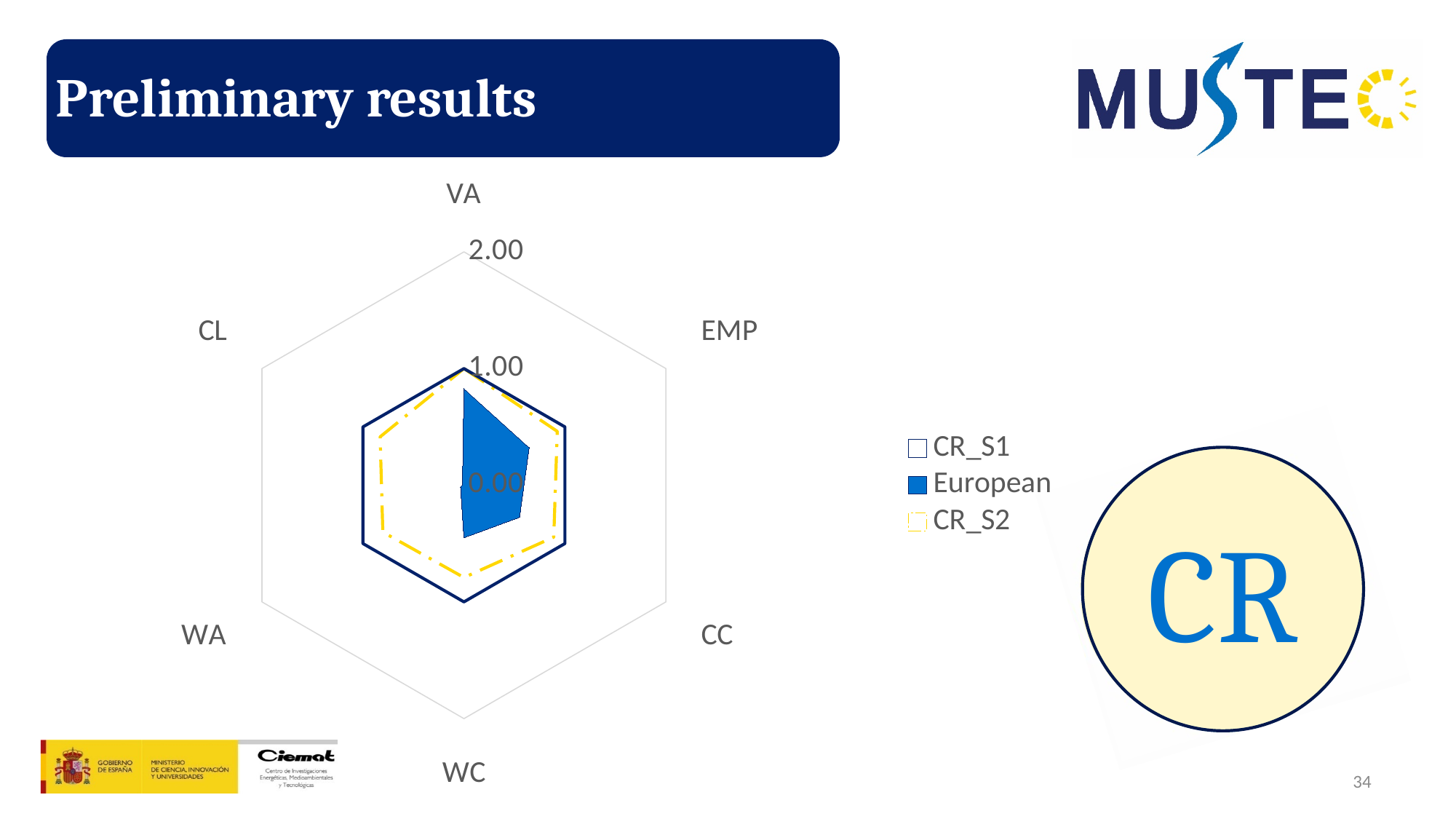
For the European series, which is larger: the value for EMP or the value for CC? EMP On the WC axis, which series has the larger value: CR_S1 or CR_S2? CR_S1 How many series does the legend list? 3 Is the European value for EMP greater or less than 1.00? less On which axis does the European series reach its highest value? VA How many axes (categories) does the radar chart have? 6 What kind of chart is shown on the slide? Radar chart Is the European value for CC greater or less than 1.00? less What is the highest value shown on the radar chart's axis scale? 2.00 Is the CR_S1 value for WC greater or less than 2.00? less Which series are listed in the legend? CR_S1, European, CR_S2 For the European series, which is larger: the value for VA or the value for WA? VA